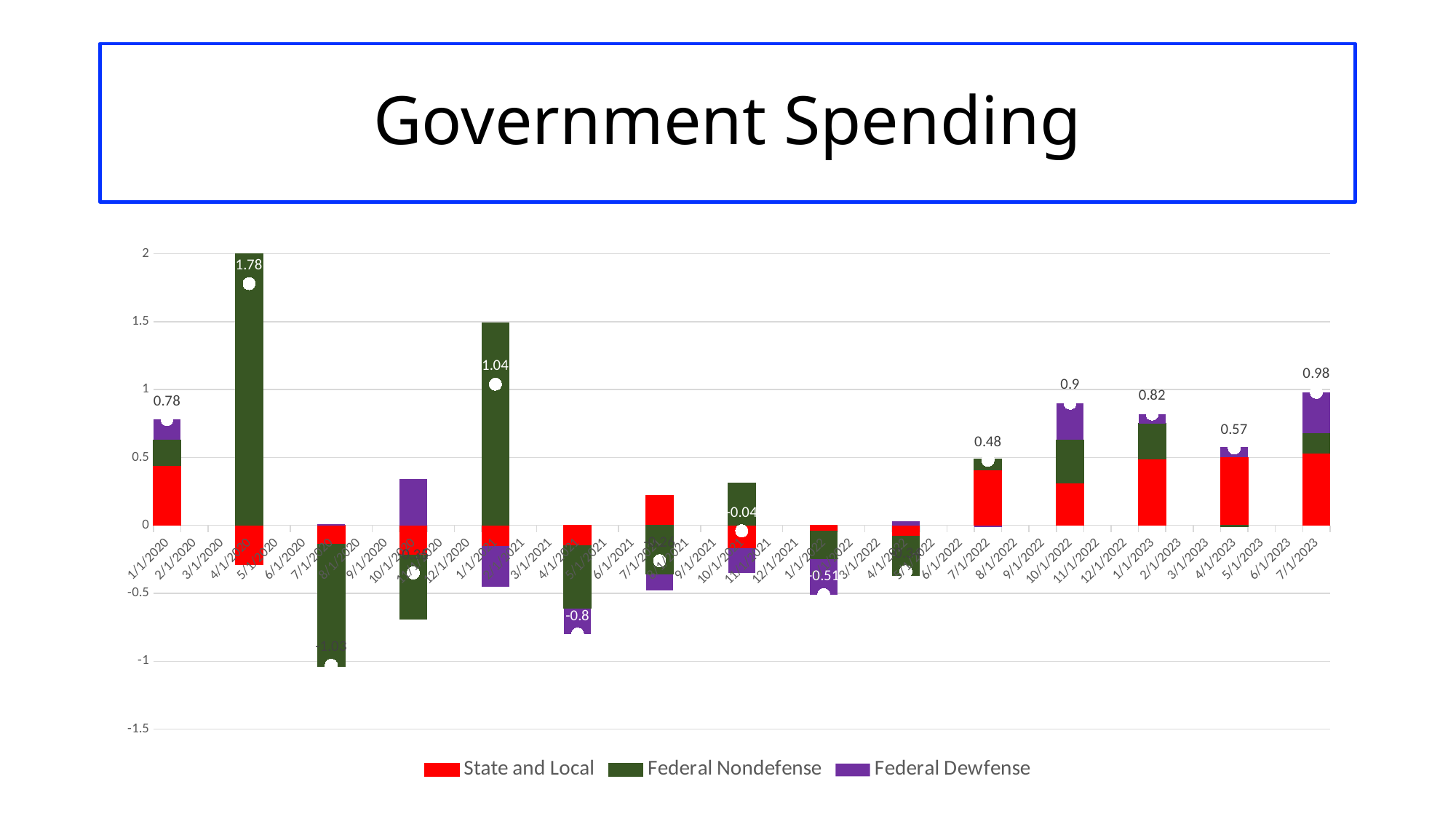
Which has the larger labelled total, 10/1/2022 or 1/1/2023? 10/1/2022 How many series does the legend list? 3 Which date has the highest labelled total value? 4/1/2020 What is the labelled total value for 4/1/2020? 1.78 What is the labelled total value for 1/1/2020? 0.78 What is the difference between the labelled totals for 7/1/2023 and 10/1/2022? 0.08 Which date has the lowest total value? 7/1/2020 What is the title of the slide? Government Spending What kind of chart is shown on the slide? Stacked bar chart with a marker (line) series showing the totals Is the Federal Nondefense value for 1/1/2021 greater or less than 1? greater What is the labelled total value for 1/1/2022? -0.51 What is the labelled total value for 7/1/2023? 0.98